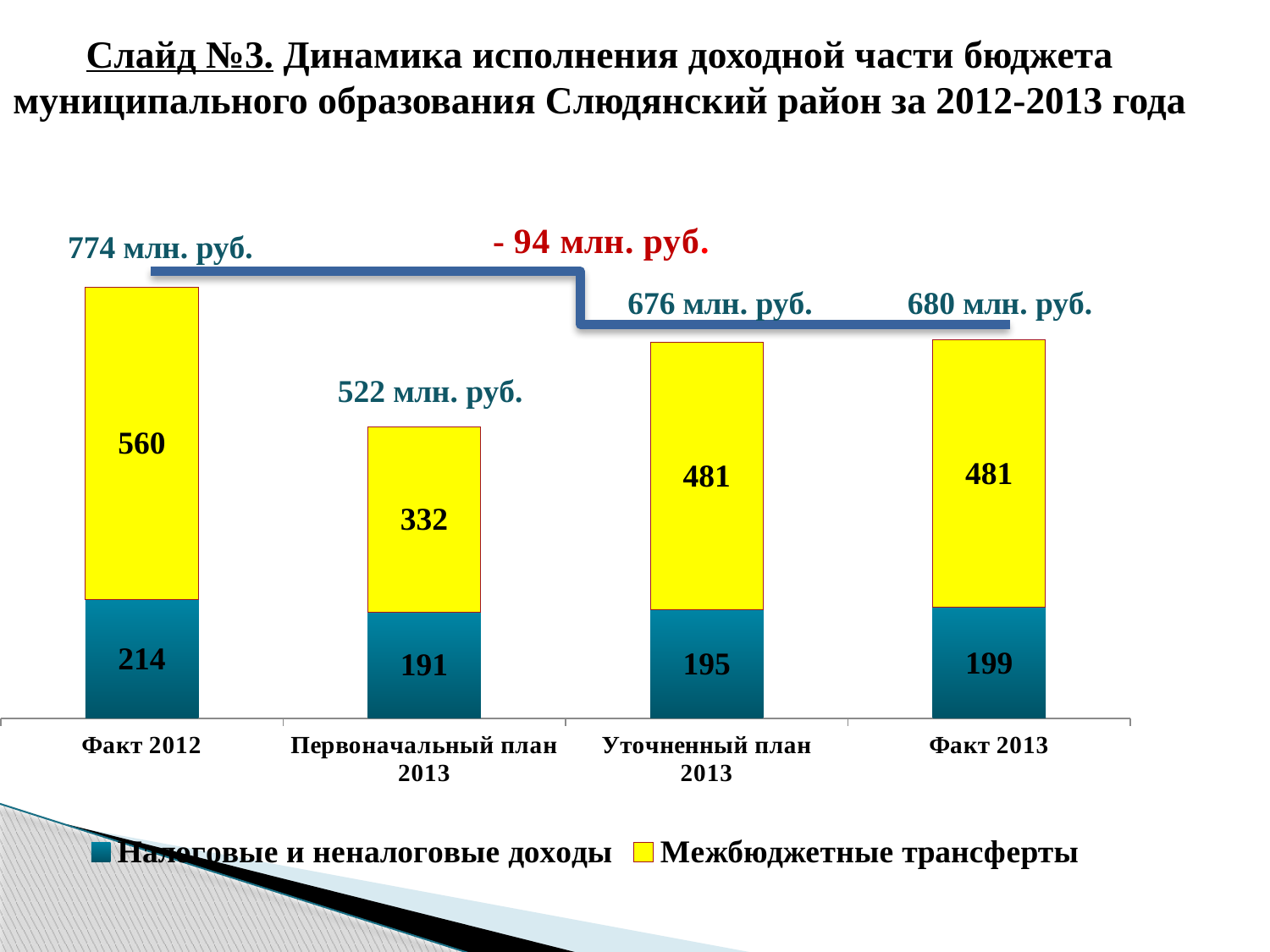
What kind of chart is shown on the slide? Stacked bar chart What is the total of the stacked bar for Уточненный план 2013? 676 млн. руб. Which category has the highest value of Межбюджетные трансферты? Факт 2012 What is the difference between Межбюджетные трансферты for Факт 2012 and for Факт 2013? 79 What is the value of Межбюджетные трансферты for Первоначальный план 2013? 332 How many categories are shown on the x axis? 4 Which category has the lowest value of Налоговые и неналоговые доходы? Первоначальный план 2013 How many series does the legend list? 2 What is the total of the stacked bar for Первоначальный план 2013? 522 млн. руб. What is the value of Налоговые и неналоговые доходы for Факт 2013? 199 What is the value of Налоговые и неналоговые доходы for Факт 2012? 214 Which is larger: Налоговые и неналоговые доходы for Уточненный план 2013 or for Факт 2013? Факт 2013